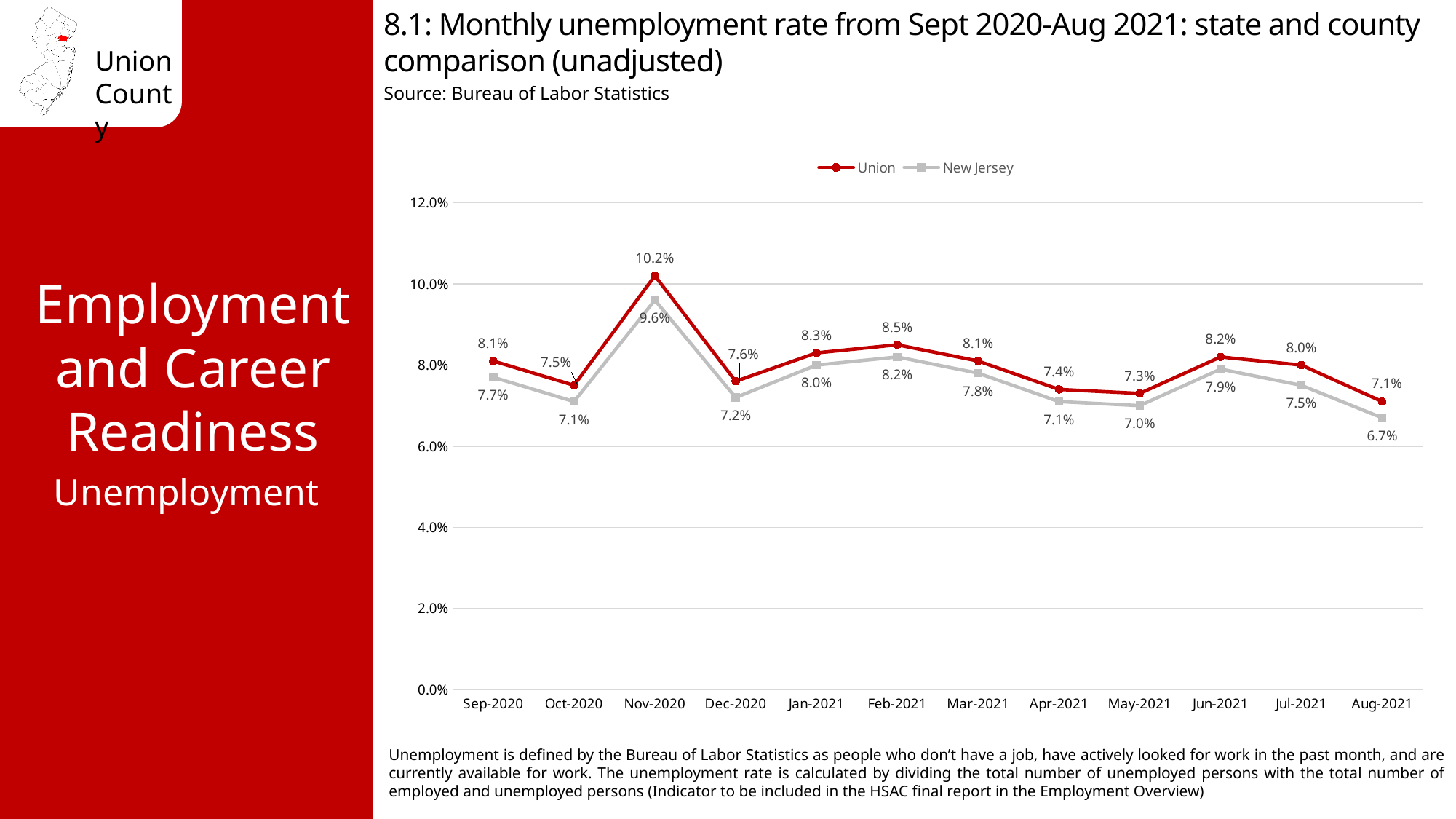
What was the unemployment rate for New Jersey in Jan-2021? 8.0% In which month was the Union unemployment rate highest? Nov-2020 What was the unemployment rate for Union in Feb-2021? 8.5% Which was higher in Dec-2020, the Union rate or the New Jersey rate? Union How many months are plotted on the x axis? 12 What is the difference between the Union and New Jersey unemployment rates in Nov-2020? 0.6% In which month was the New Jersey unemployment rate lowest? Aug-2021 What was the unemployment rate for Union in Nov-2020? 10.2% What was the unemployment rate for New Jersey in Aug-2021? 6.7% How many series does the legend list? 2 What kind of chart is shown on the slide? Line chart Is the Union unemployment rate in Nov-2020 greater or less than 10.0%? greater